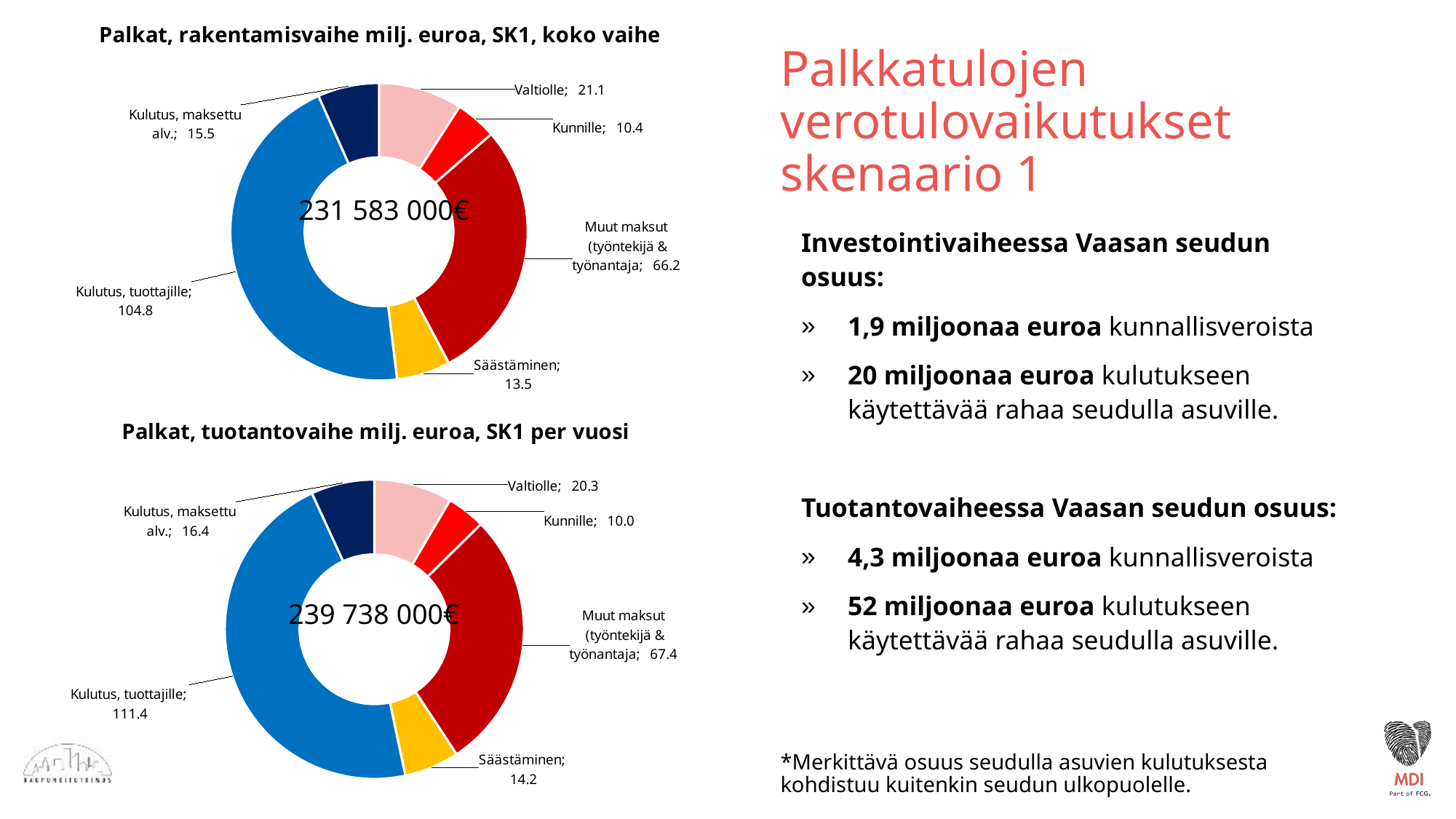
In the bottom chart (Palkat, tuotantovaihe), what is the value for Säästäminen? 14.2 How many categories does the top chart (Palkat, rakentamisvaihe) show? 6 In the bottom chart (Palkat, tuotantovaihe), what is the value for Valtiolle? 20.3 What total amount is printed in the centre of the top chart (Palkat, rakentamisvaihe)? 231 583 000€ In the bottom chart (Palkat, tuotantovaihe), which category has the smallest value? Kunnille In the top chart (Palkat, rakentamisvaihe), what is the value for Kulutus, tuottajille? 104.8 What total amount is printed in the centre of the bottom chart (Palkat, tuotantovaihe)? 239 738 000€ In the top chart (Palkat, rakentamisvaihe), which category has the largest value? Kulutus, tuottajille In the bottom chart (Palkat, tuotantovaihe), which is larger: Kulutus, maksettu alv. or Säästäminen? Kulutus, maksettu alv. In the top chart (Palkat, rakentamisvaihe), what is the difference between Valtiolle and Kunnille? 10.7 What kind of chart is the bottom chart (Palkat, tuotantovaihe)? pie chart (doughnut) In the top chart (Palkat, rakentamisvaihe), what is the value for Muut maksut (työntekijä & työnantaja)? 66.2